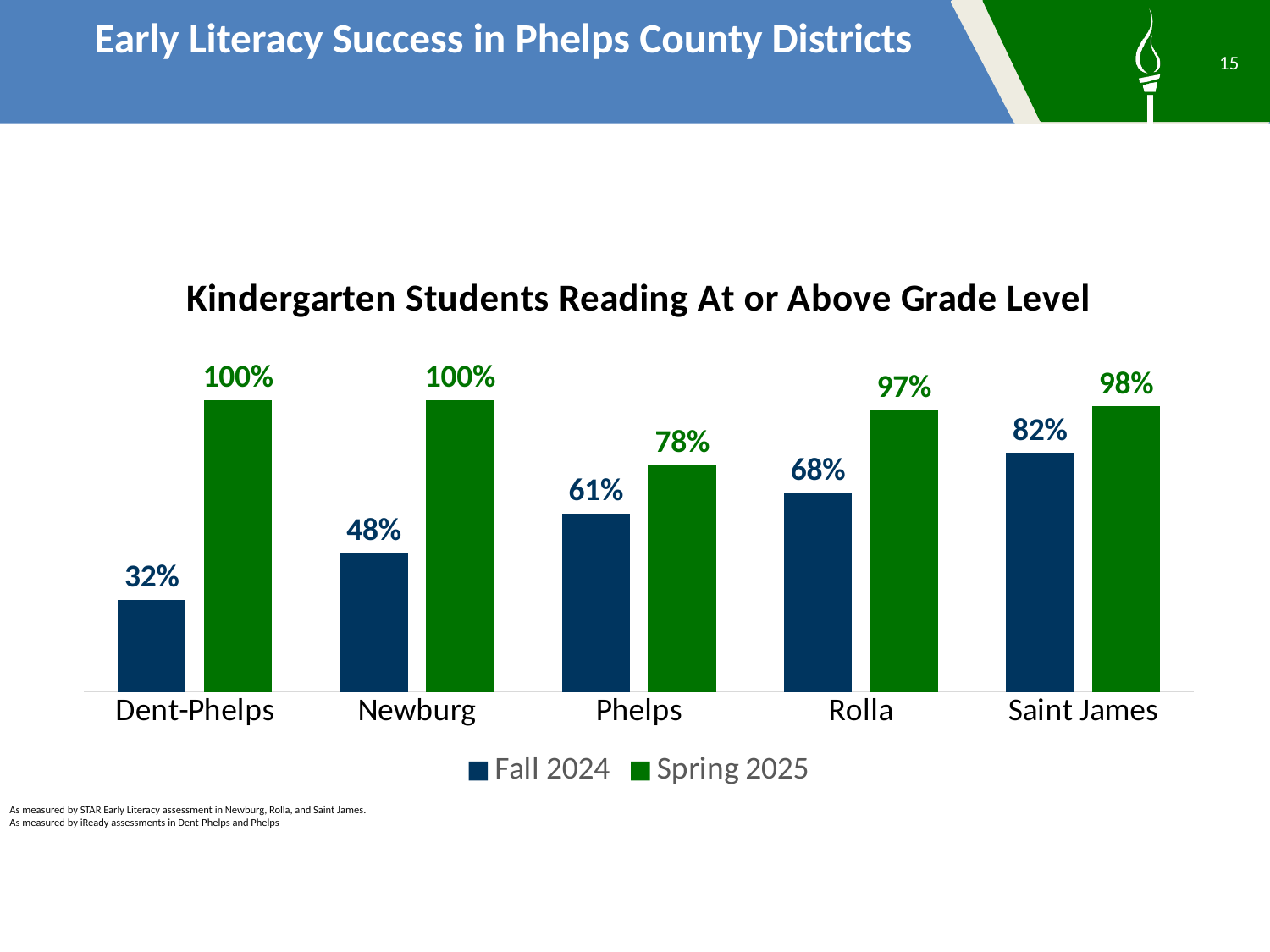
What is the difference between the Fall 2024 values for Newburg and Dent-Phelps? 16% Which district has the lowest Spring 2025 value? Phelps How many series does the legend list? 2 Which is larger, the Fall 2024 value for Phelps or the Fall 2024 value for Rolla? Rolla How many districts are shown on the x axis? 5 What is the difference between the Spring 2025 and Fall 2024 values for Rolla? 29% What is the Fall 2024 value for Saint James? 82% What kind of chart is shown? Bar chart What is the Fall 2024 value for Dent-Phelps? 32% Which district has the highest Fall 2024 value? Saint James What is the Spring 2025 value for Phelps? 78% Which district has the lowest Fall 2024 value? Dent-Phelps